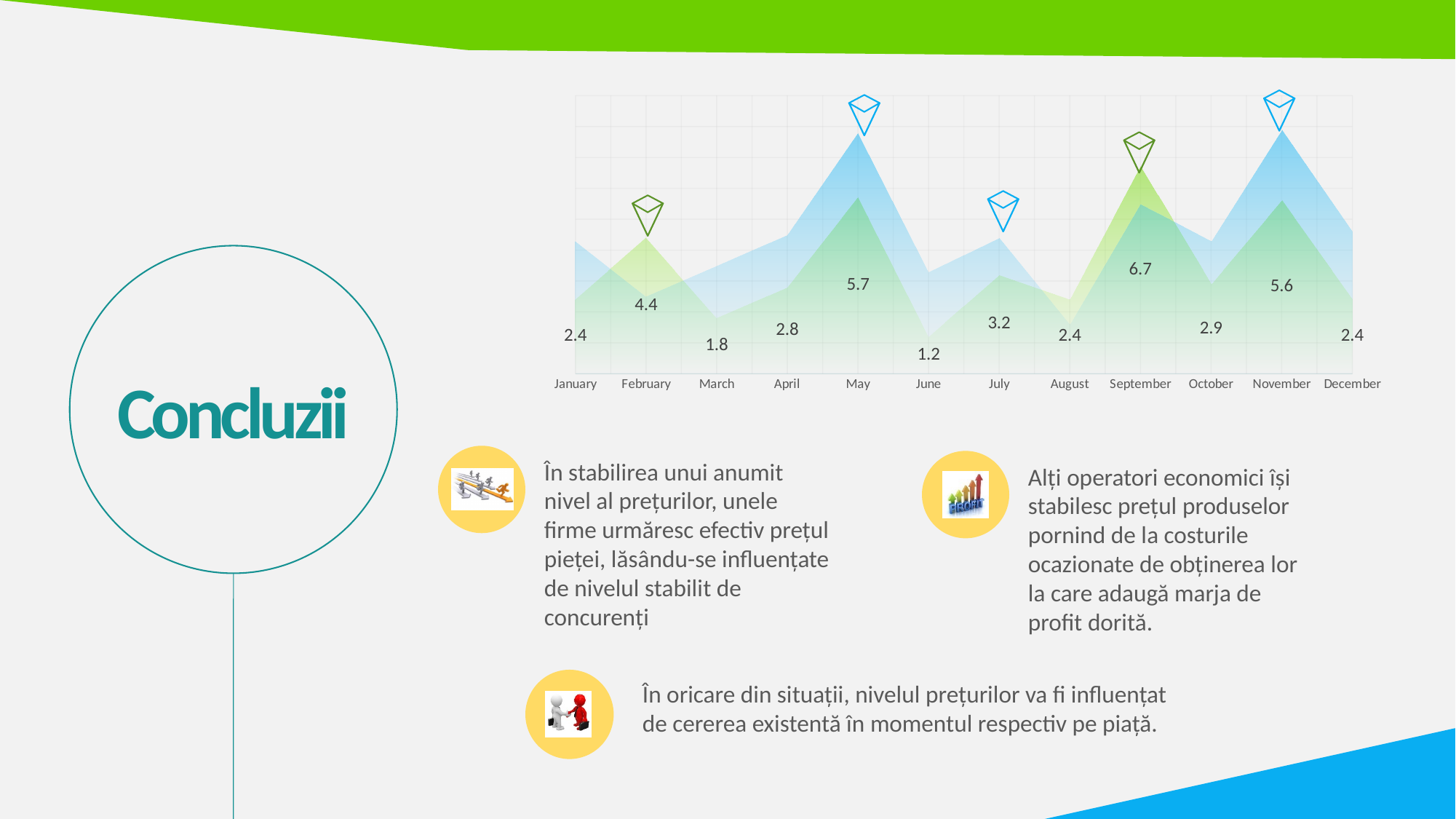
What is the labelled value for June? 1.2 Which month has the highest labelled value? September Which has the larger labelled value, November or October? November Which month has the lowest labelled value? June What is the labelled value for February? 4.4 Do the labelled values rise or fall from May to June? Fall How many months are shown on the x axis? 12 What is the difference between the labelled values for September and June? 5.5 What is the labelled value for May? 5.7 What is the labelled value for September? 6.7 What is the difference between the labelled values for May and April? 2.9 What kind of chart is shown on the slide? Area chart